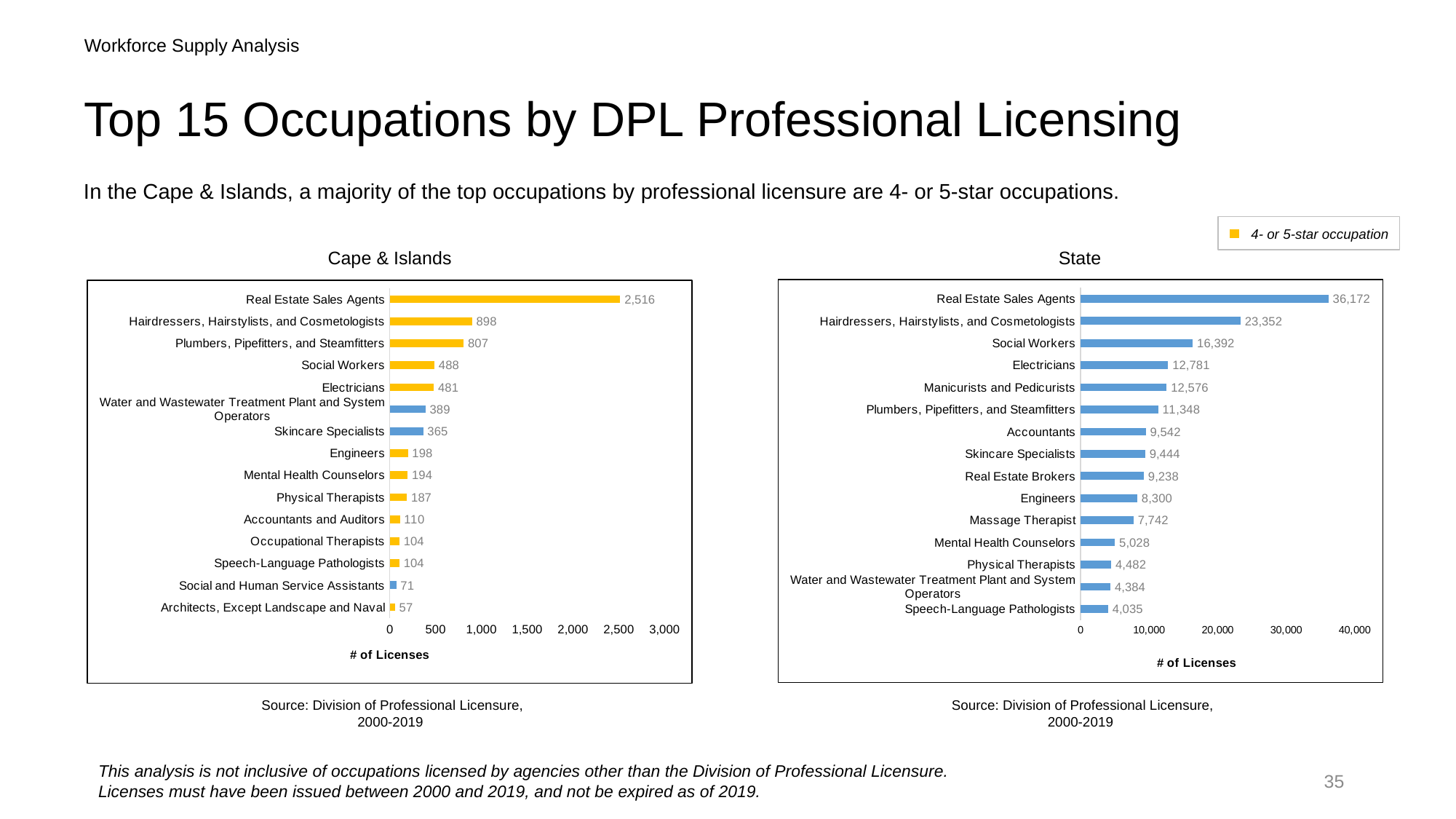
In the State chart, which has more licenses: Accountants or Skincare Specialists? Accountants In the Cape & Islands chart, which occupation has the fewest licenses? Architects, Except Landscape and Naval In the Cape & Islands chart, how many licenses are shown for Real Estate Sales Agents? 2,516 According to the legend, what does a yellow bar indicate? 4- or 5-star occupation What type of chart is the State chart? Bar chart In the State chart, how many licenses are shown for Social Workers? 16,392 How many occupations are listed in the Cape & Islands chart? 15 In the Cape & Islands chart, which has more licenses: Social Workers or Electricians? Social Workers In the State chart, what is the difference in licenses between Real Estate Sales Agents and Hairdressers, Hairstylists, and Cosmetologists? 12,820 In the State chart, how many licenses are shown for Speech-Language Pathologists? 4,035 In the Cape & Islands chart, what is the difference in licenses between Hairdressers, Hairstylists, and Cosmetologists and Plumbers, Pipefitters, and Steamfitters? 91 In the State chart, which occupation has the most licenses? Real Estate Sales Agents